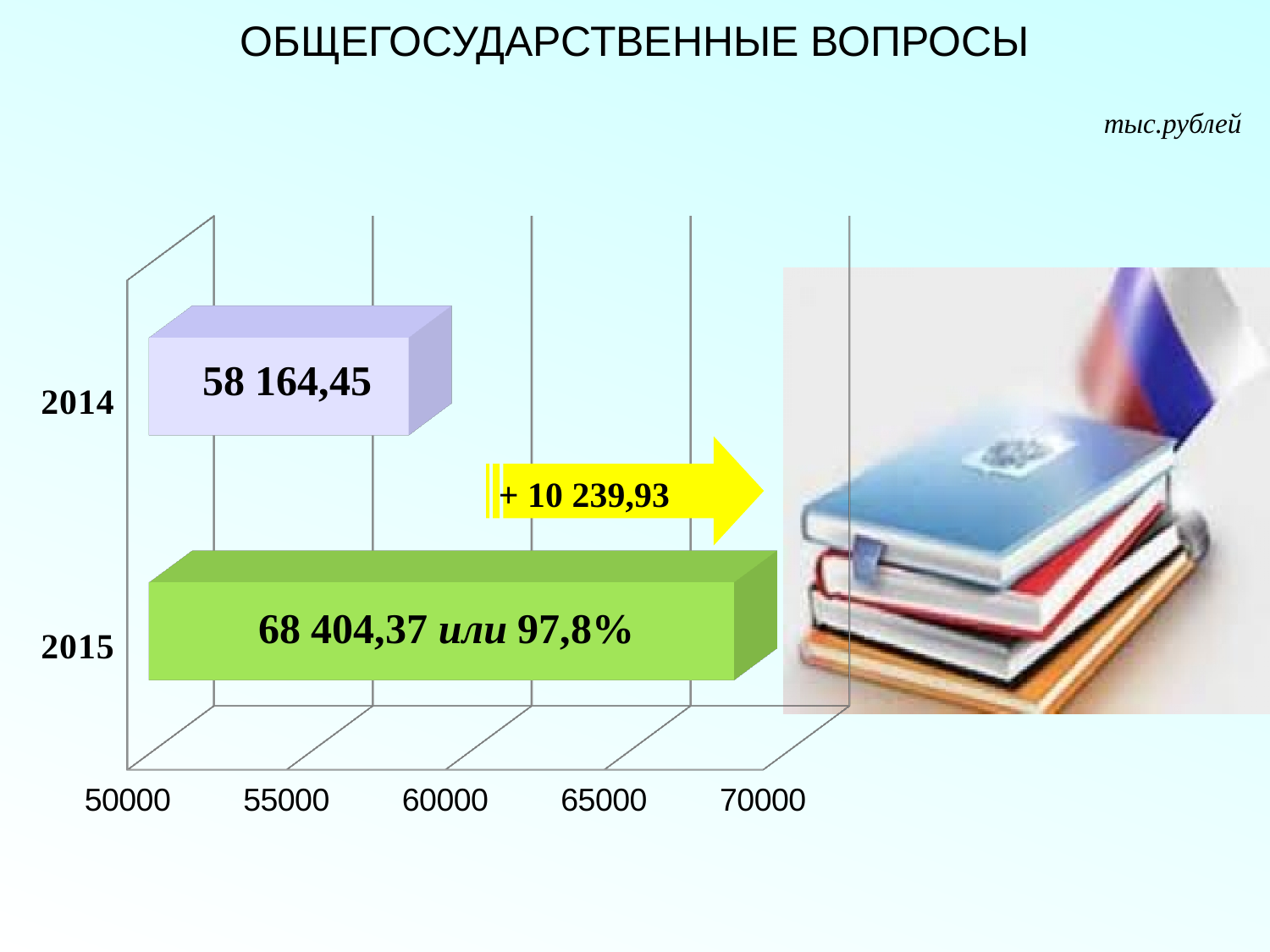
What kind of chart is shown on the slide? bar chart What is the difference between the 2015 and 2014 values, as shown on the arrow? + 10 239,93 What percentage is shown next to the 2015 value? 97,8% What unit of measurement is indicated on the slide? тыс.рублей Is the value for 2015 greater or less than 65000? greater Is the value for 2014 greater or less than 60000? less Is the value for 2014 larger or smaller than the value for 2015? smaller What is the value for 2014? 58 164,45 How many years (bars) are shown in the chart? 2 Which year has the higher value? 2015 Which year has the lower value? 2014 What is the value for 2015? 68 404,37